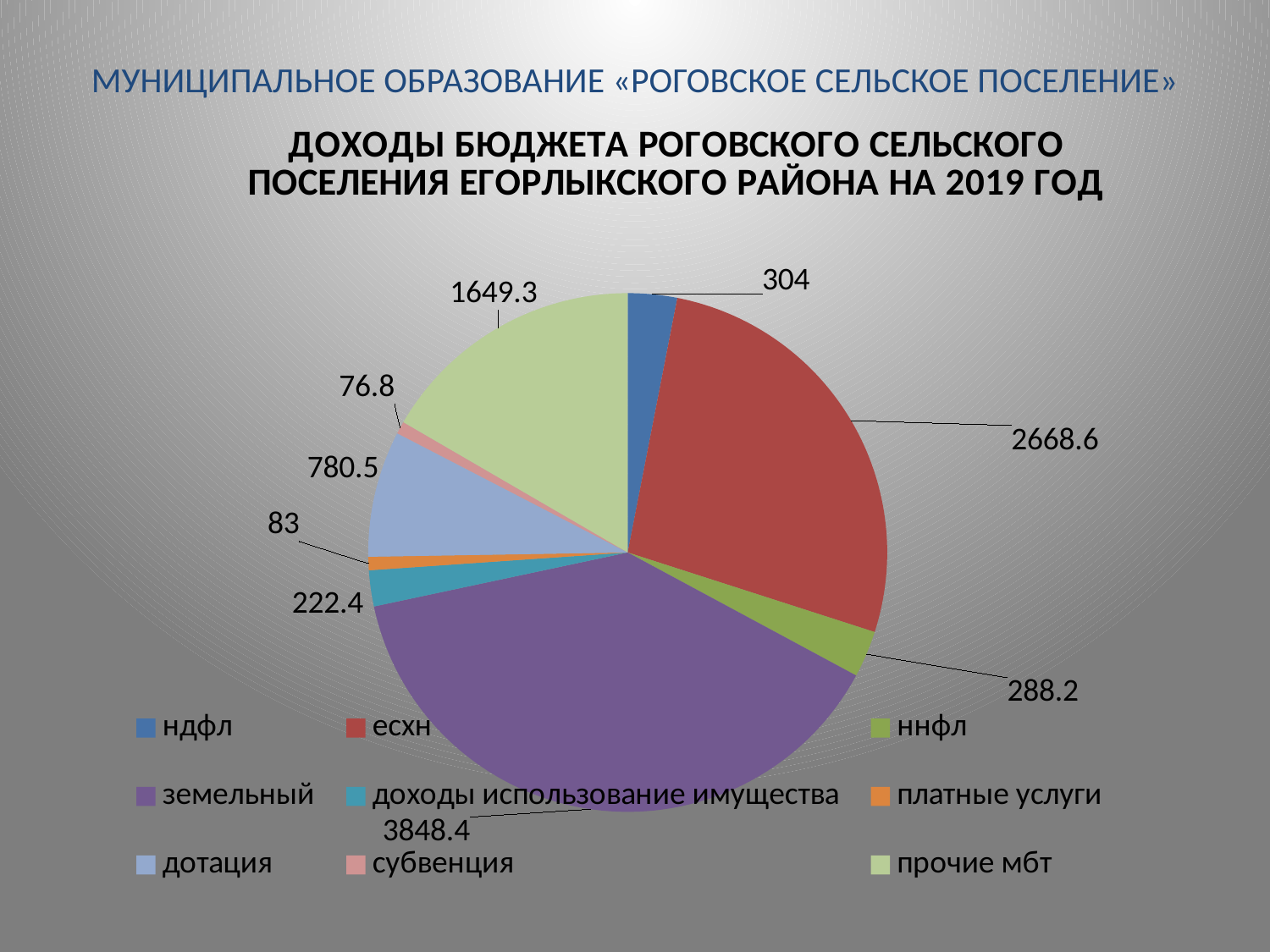
Which category has the smallest value? субвенция Which category is shown in red? есхн Which category has the largest value? земельный What type of chart is shown on the slide? pie chart What is the value for земельный? 3848.4 What is the difference between the values for прочие мбт and дотация? 868.8 Which is larger, the value for ннфл or the value for ндфл? ндфл How many categories does the pie chart have? 9 What is the difference between the values for есхн and ндфл? 2364.6 What is the value for дотация? 780.5 What is the value for есхн? 2668.6 What is the value for субвенция? 76.8